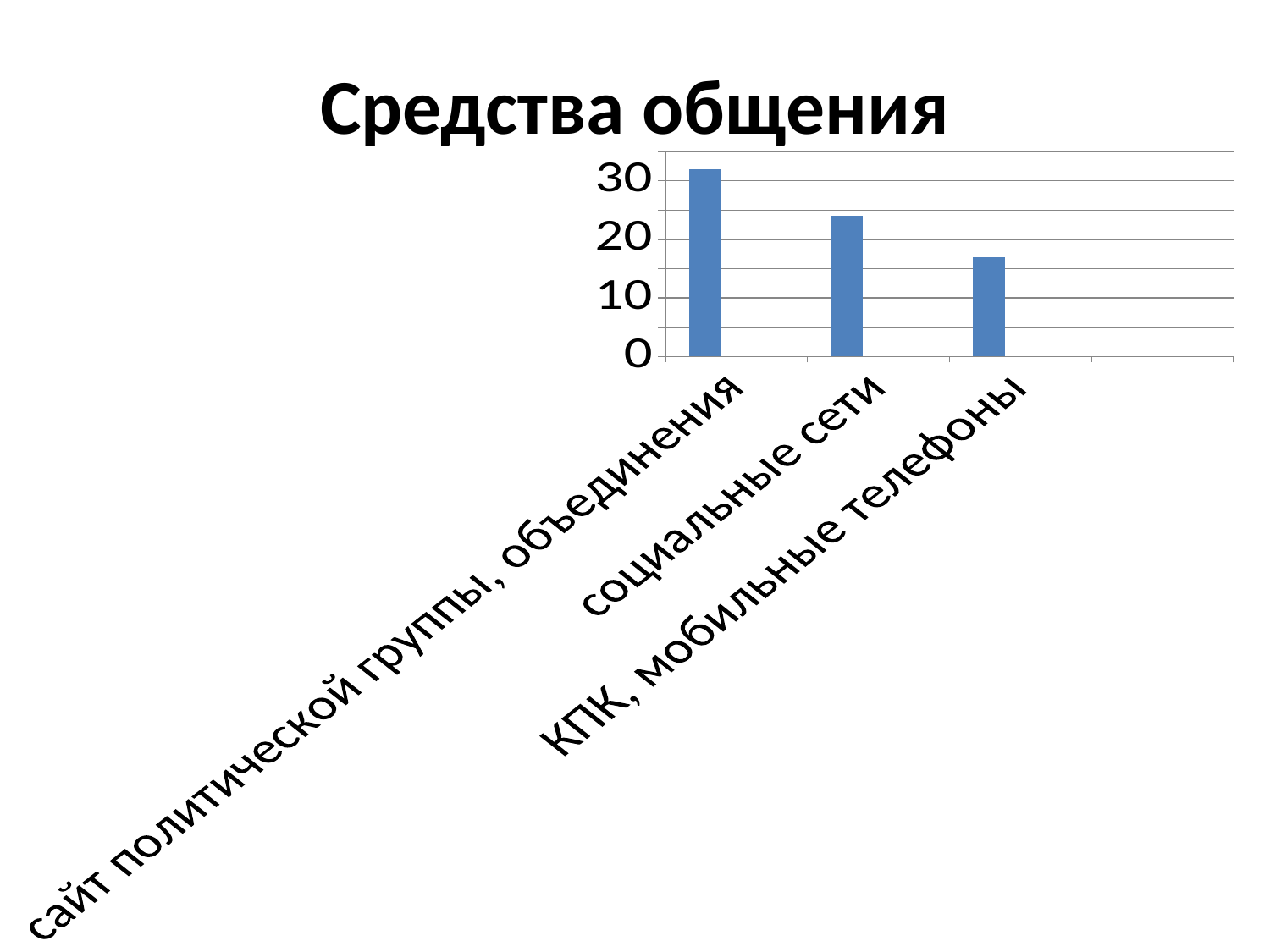
What kind of chart is shown on the slide? bar chart Is the value for сайт политической группы, объединения greater or less than 30? greater How many categories are plotted in the chart? 3 Is the value for КПК, мобильные телефоны greater or less than 20? less Do the values rise or fall from left to right along the x axis? fall Is the value for социальные сети greater or less than 30? less Which category has the lowest value? КПК, мобильные телефоны Which is larger: the value for сайт политической группы, объединения or the value for социальные сети? сайт политической группы, объединения Which category has the highest value? сайт политической группы, объединения Which is larger: the value for социальные сети or the value for КПК, мобильные телефоны? социальные сети What is the title of the chart? Средства общения